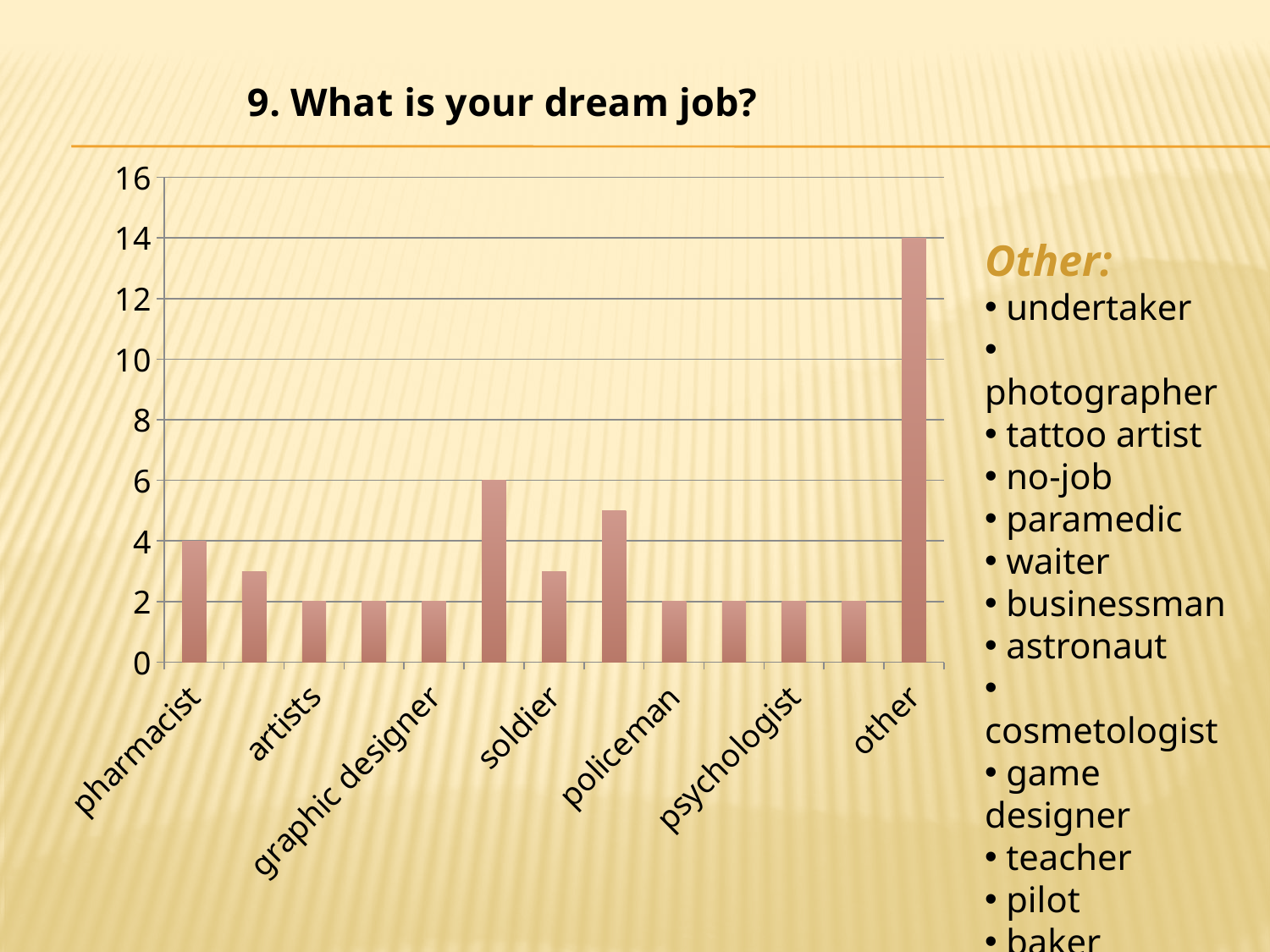
How many bars are plotted in the chart? 13 What kind of chart is shown on the slide? bar chart What is the difference between the values for other and pharmacist? 10 Is the value for other greater or less than 10? greater What is the value for other? 14 What is the value for policeman? 2 Which category has the highest value? other What is the value for pharmacist? 4 What is the title of the slide? 9. What is your dream job? What is the value for artists? 2 Which is larger, the value for pharmacist or the value for artists? pharmacist Is the value for soldier greater or less than 4? less